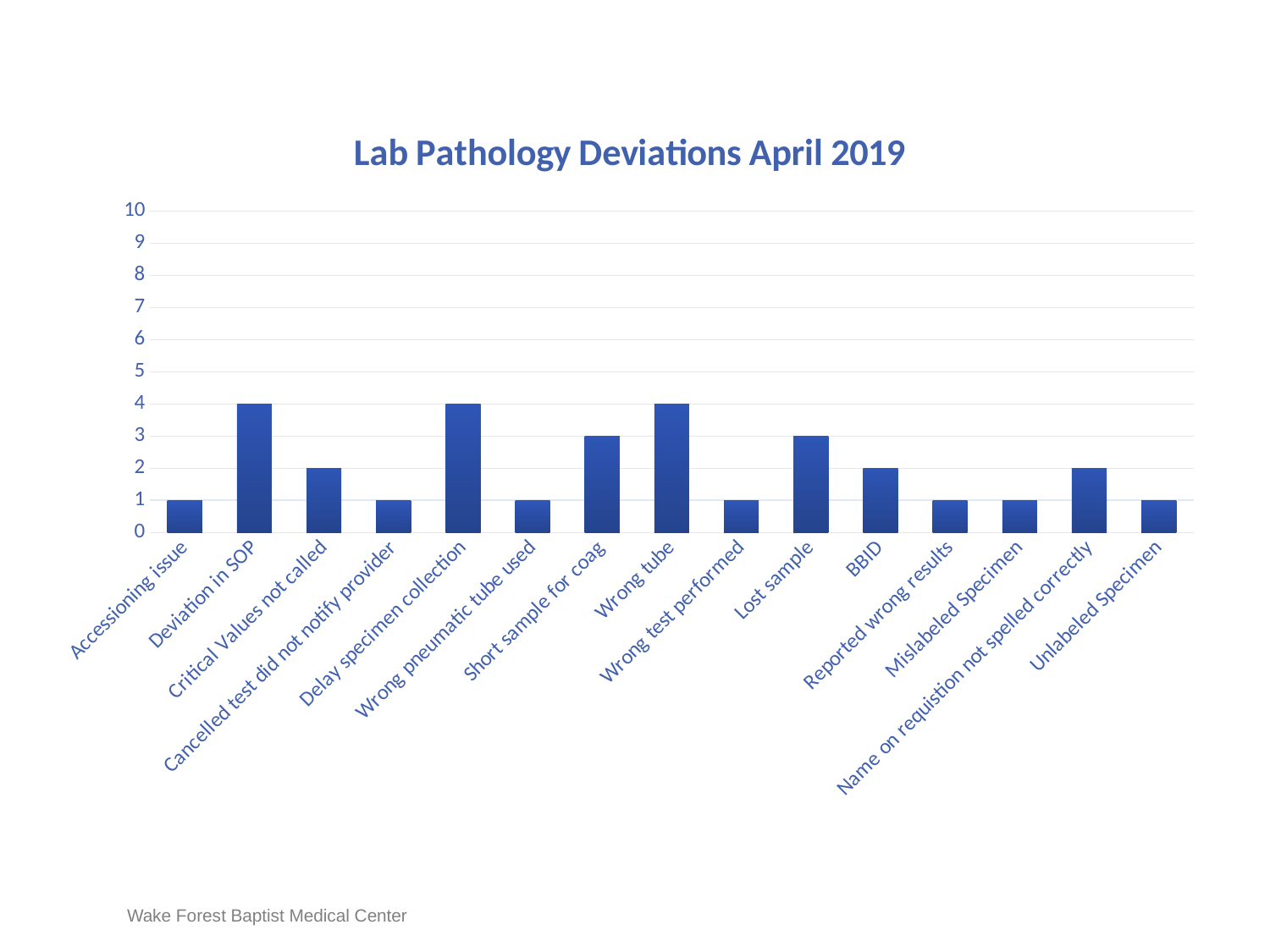
Which is larger, the value for Wrong tube or the value for Wrong test performed? Wrong tube What is the value for Unlabeled Specimen? 1 What is the value for Lost sample? 3 Which is larger, the value for Critical Values not called or the value for Delay specimen collection? Delay specimen collection What is the difference between the value for Wrong tube and the value for Mislabeled Specimen? 3 How many categories are shown on the x axis of the chart? 15 What is the title of the chart? Lab Pathology Deviations April 2019 What type of chart is shown on the slide? bar chart What is the value for BBID? 2 What is the value for Short sample for coag? 3 What is the value for Deviation in SOP? 4 Is the value for Deviation in SOP greater or less than 5? less